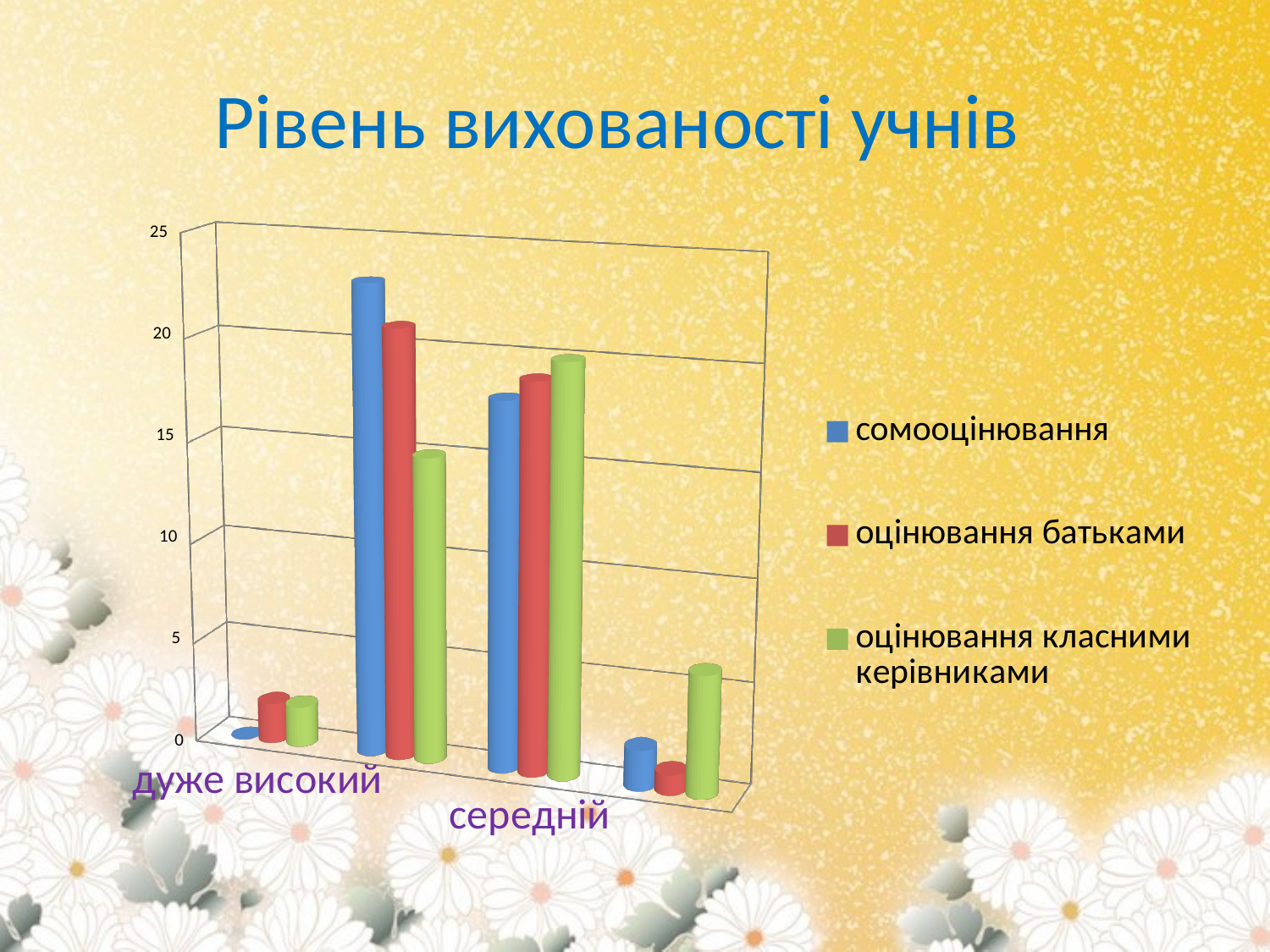
What is the title of the chart? Рівень вихованості учнів How many series does the legend list? 3 Is the value for оцінювання батьками in the середній category greater or less than 10? greater Is the value for сомооцінювання in the дуже високий category greater or less than 5? less What kind of chart is shown on the slide? bar chart Is the value for сомооцінювання in the середній category greater or less than 15? greater In the середній category, which is larger: the value for сомооцінювання or the value for оцінювання класними керівниками? оцінювання класними керівниками Which series is shown in green in the legend? оцінювання класними керівниками For the сомооцінювання series, which is larger: the value for дуже високий or the value for середній? середній